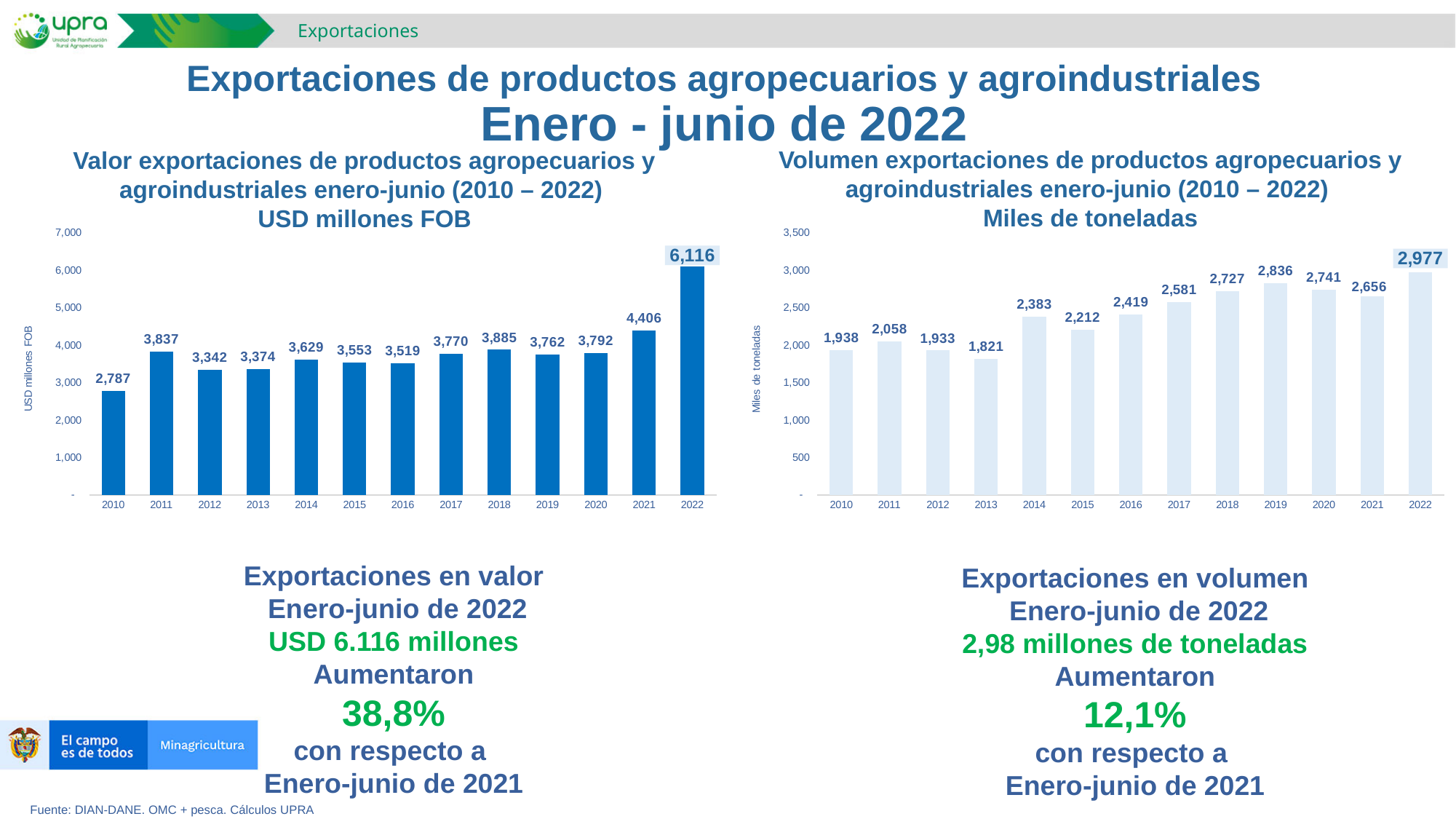
In the left chart (Valor exportaciones, USD millones FOB), what is the value for 2014? 3,629 In the right chart (Volumen exportaciones, Miles de toneladas), what is the difference between the 2019 and 2018 values? 109 In the right chart (Volumen exportaciones, Miles de toneladas), is the value for 2016 greater or less than 2,500? less In the left chart (Valor exportaciones, USD millones FOB), which year has the lowest value? 2010 In the left chart (Valor exportaciones, USD millones FOB), how many years are plotted? 13 In the right chart (Volumen exportaciones, Miles de toneladas), which year has the highest value? 2022 What type of chart is the right chart (Volumen exportaciones, Miles de toneladas)? Bar chart In the left chart (Valor exportaciones, USD millones FOB), which is larger, the value for 2011 or the value for 2018? 2018 What is the y-axis label of the left chart (Valor exportaciones)? USD millones FOB In the right chart (Volumen exportaciones, Miles de toneladas), what is the value for 2013? 1,821 In the left chart (Valor exportaciones, USD millones FOB), what is the difference between the 2022 and 2021 values? 1,710 In the left chart (Valor exportaciones, USD millones FOB), what is the value for 2022? 6,116